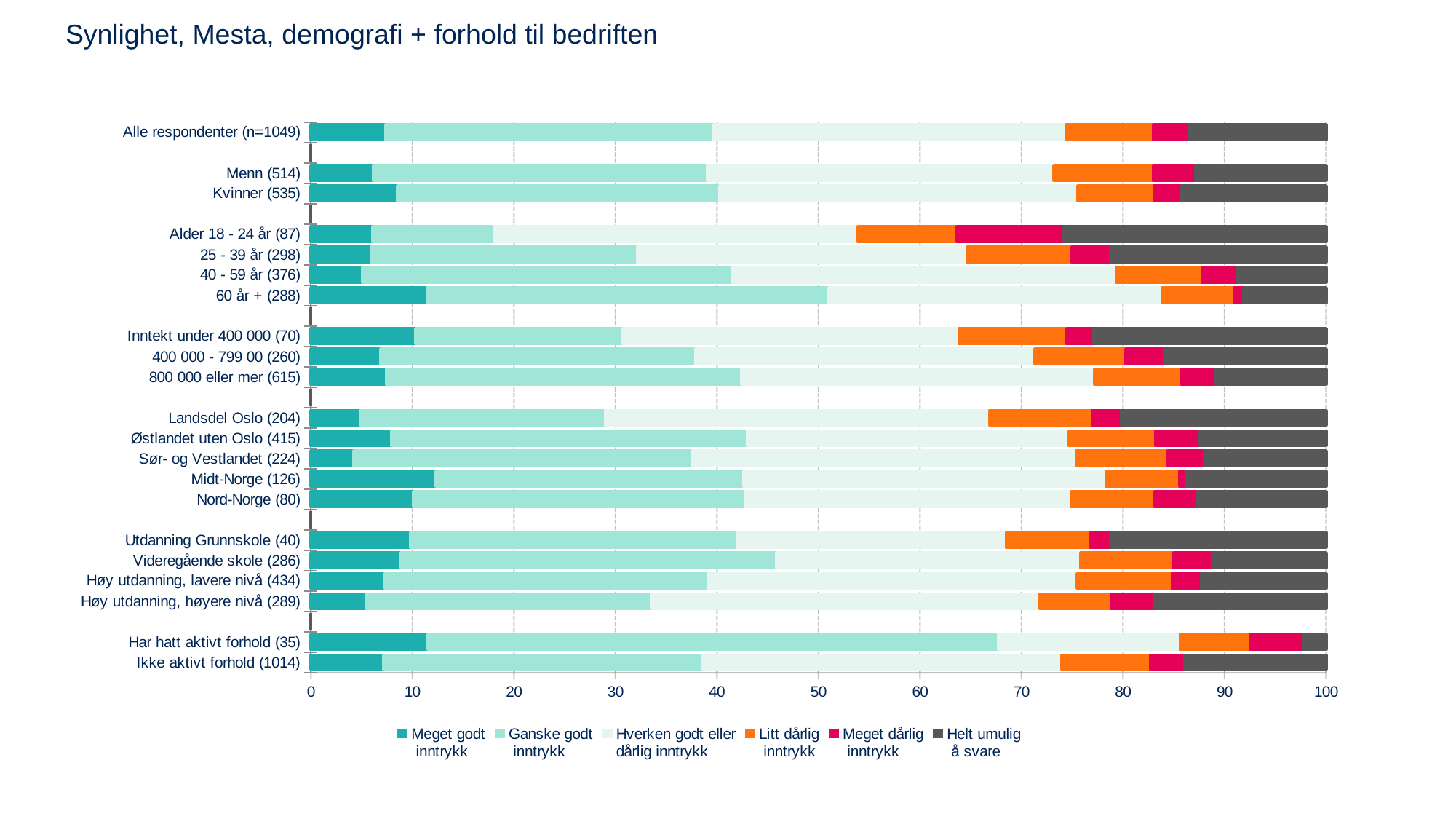
Is the 'Meget godt inntrykk' value for Midt-Norge (126) greater or less than 10? greater Which group has the smallest 'Helt umulig å svare' segment? Har hatt aktivt forhold (35) What kind of chart is shown on the slide? Stacked bar chart How many respondent groups (bars) are plotted on the chart? 21 Which group has the largest 'Helt umulig å svare' segment? Alder 18 - 24 år (87) Which group has the largest 'Meget dårlig inntrykk' segment? Alder 18 - 24 år (87) Which legend entry is shown in dark grey? Helt umulig å svare How many series does the legend list? 6 Is the 'Helt umulig å svare' value for Alder 18 - 24 år (87) greater or less than 20? greater Which has the larger 'Meget godt inntrykk' segment, Midt-Norge (126) or Sør- og Vestlandet (224)? Midt-Norge (126) What is the title of the slide? Synlighet, Mesta, demografi + forhold til bedriften Which group has the largest 'Ganske godt inntrykk' segment? Har hatt aktivt forhold (35)